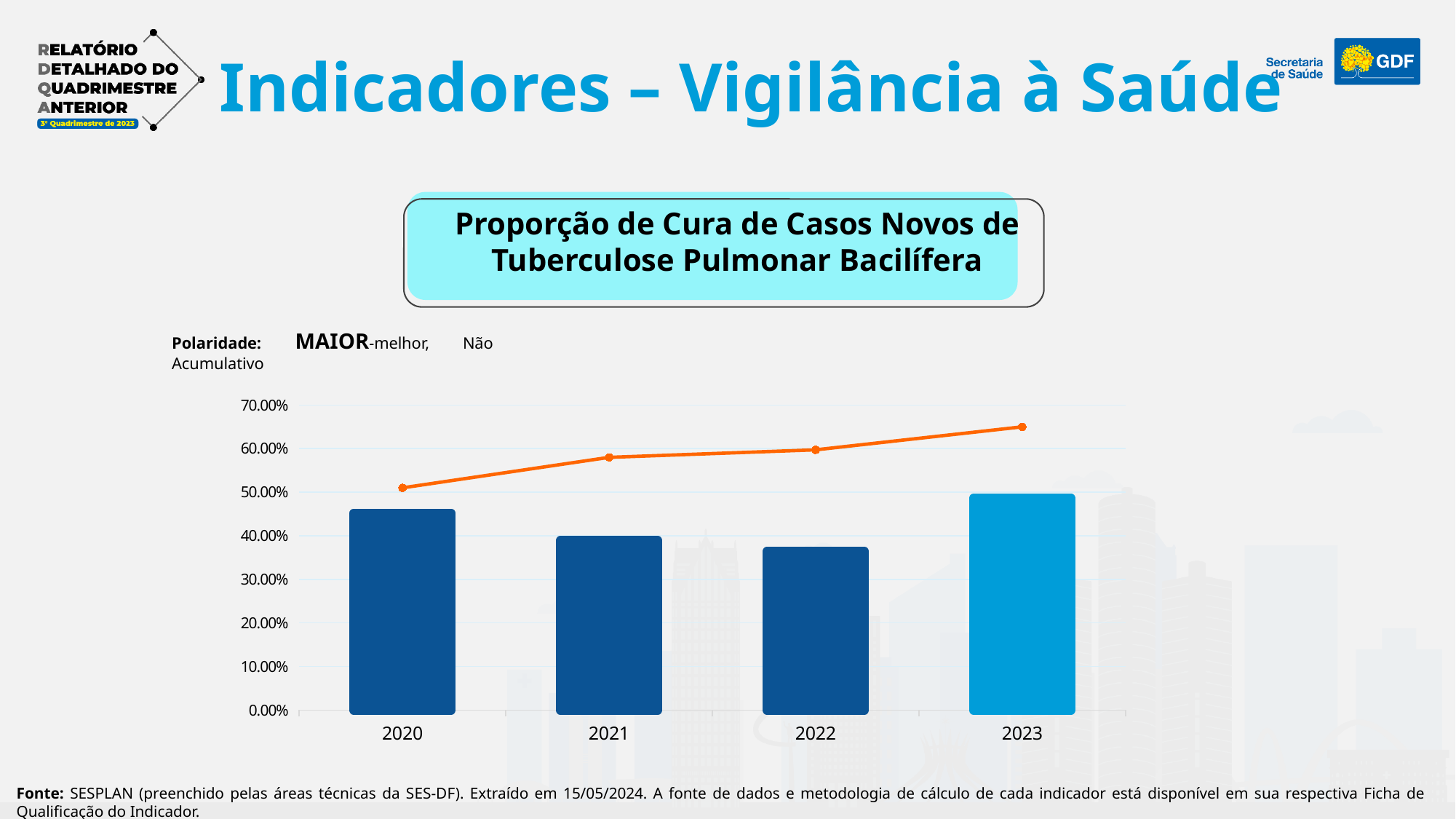
Is the bar value for 2021 greater or less than 30.00%? greater Which bar is taller, 2020 or 2021? 2020 What is the title of the chart? Proporção de Cura de Casos Novos de Tuberculose Pulmonar Bacilífera Does the orange line rise or fall from 2020 to 2023? rises Is the bar value for 2022 greater or less than 40.00%? less Which year has the tallest bar? 2023 Is the bar value for 2020 greater or less than 50.00%? less How many years are shown on the x axis of the chart? 4 What kind of chart is shown on the slide? A bar chart with a line overlay In which year does the orange line reach its lowest point? 2020 Which year has the shortest bar? 2022